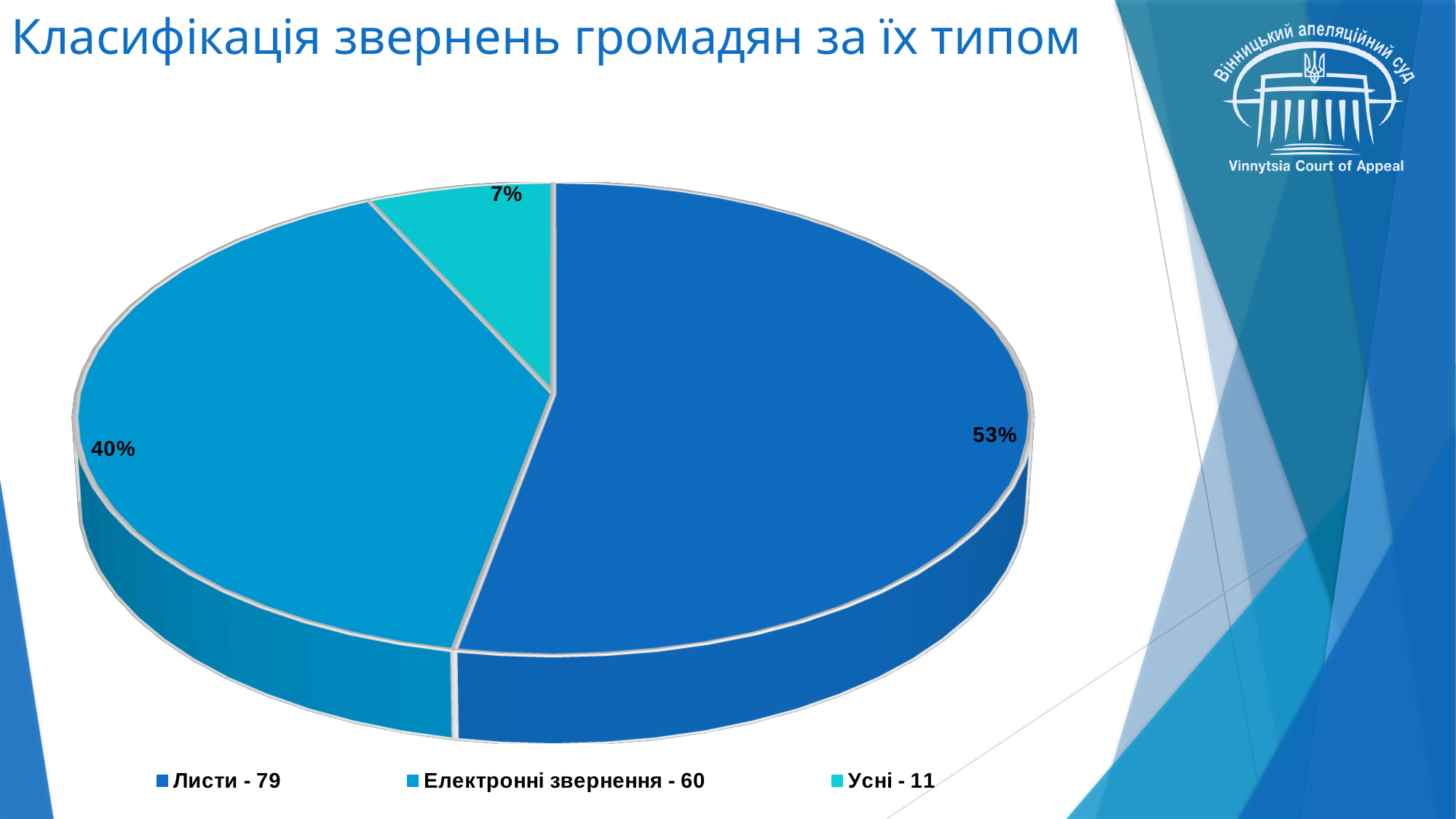
What percentage share does the "Електронні звернення - 60" slice have? 40% Which category has the largest share of the pie? Листи - 79 How many slices does the pie chart have? 3 What percentage share does the "Листи - 79" slice have? 53% What is the difference in percentage points between the "Листи - 79" slice and the "Усні - 11" slice? 46% How many entries does the legend list? 3 What percentage share does the "Усні - 11" slice have? 7% What is the title of the slide? Класифікація звернень громадян за їх типом What kind of chart is shown on the slide? pie chart Which category has the smallest share of the pie? Усні - 11 What is the difference in percentage points between the "Електронні звернення - 60" slice and the "Усні - 11" slice? 33% Which is larger: the share for "Листи - 79" or the share for "Електронні звернення - 60"? Листи - 79